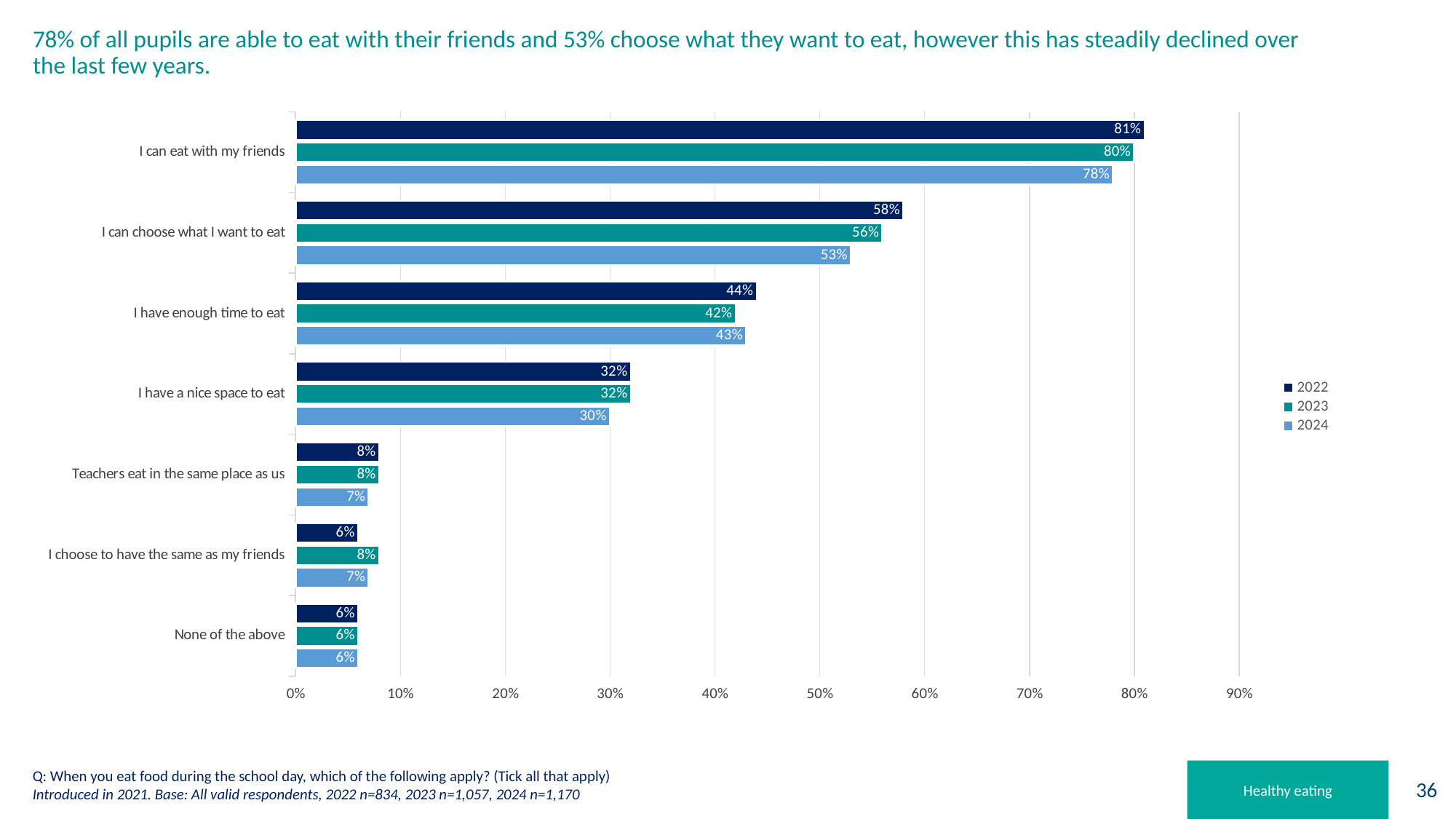
Which category has the lowest value in 2024? None of the above What is the difference between the 2022 and 2023 values for "I choose to have the same as my friends"? 2 percentage points How many categories are shown on the chart? 7 How many series does the legend list? 3 For "I have a nice space to eat", is the 2023 value larger or smaller than the 2024 value? larger Which years are listed in the chart legend? 2022, 2023, 2024 Which category has the highest value in 2022? I can eat with my friends What is the difference between the 2022 and 2024 values for "I can choose what I want to eat"? 5 percentage points What percentage of pupils said "I can eat with my friends" in 2024? 78% What percentage said "I have enough time to eat" in 2023? 42% What was the value for "I can choose what I want to eat" in 2022? 58% What kind of chart is shown on the slide? Bar chart